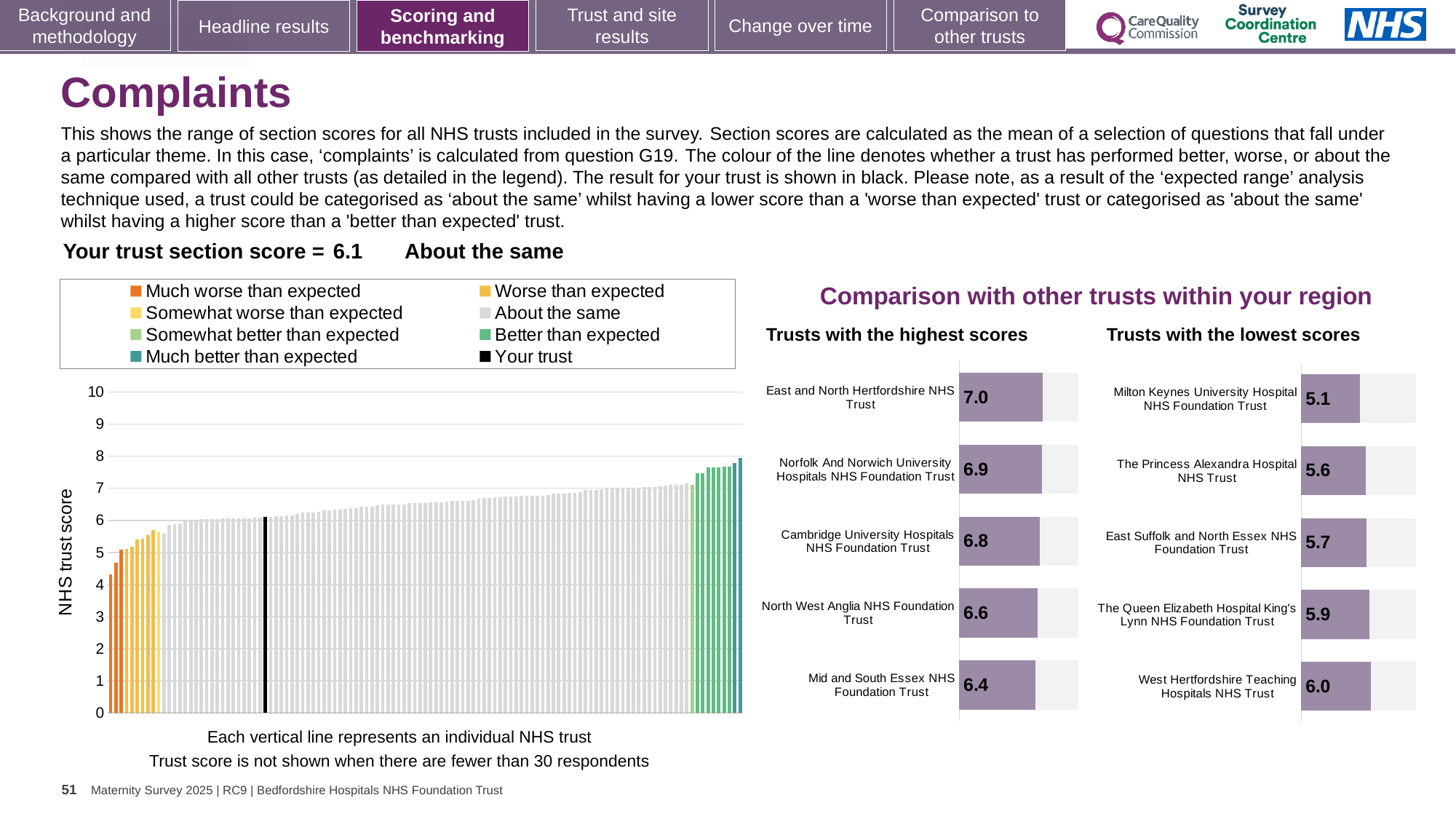
What kind of chart is the NHS trust score chart on the left of the slide? Bar chart In the NHS trust score chart on the left, do the values rise or fall from left to right? Rise In the 'Trusts with the lowest scores' chart, which trust has the highest score? West Hertfordshire Teaching Hospitals NHS Trust In the 'Trusts with the lowest scores' chart, which has the larger score: The Princess Alexandra Hospital NHS Trust or The Queen Elizabeth Hospital King's Lynn NHS Foundation Trust? The Queen Elizabeth Hospital King's Lynn NHS Foundation Trust In the NHS trust score chart on the left, is the value for 'Your trust' greater or less than 5? greater In the 'Trusts with the highest scores' chart, what is the score for Cambridge University Hospitals NHS Foundation Trust? 6.8 In the 'Trusts with the highest scores' chart, which trust has the lowest score? Mid and South Essex NHS Foundation Trust How many trusts are shown in the 'Trusts with the lowest scores' chart? 5 In the 'Trusts with the highest scores' chart, what is the difference between the scores of East and North Hertfordshire NHS Trust and Mid and South Essex NHS Foundation Trust? 0.6 How many entries does the legend of the NHS trust score chart list? 8 In the 'Trusts with the highest scores' chart, what is the score for East and North Hertfordshire NHS Trust? 7.0 In the 'Trusts with the lowest scores' chart, what is the score for Milton Keynes University Hospital NHS Foundation Trust? 5.1